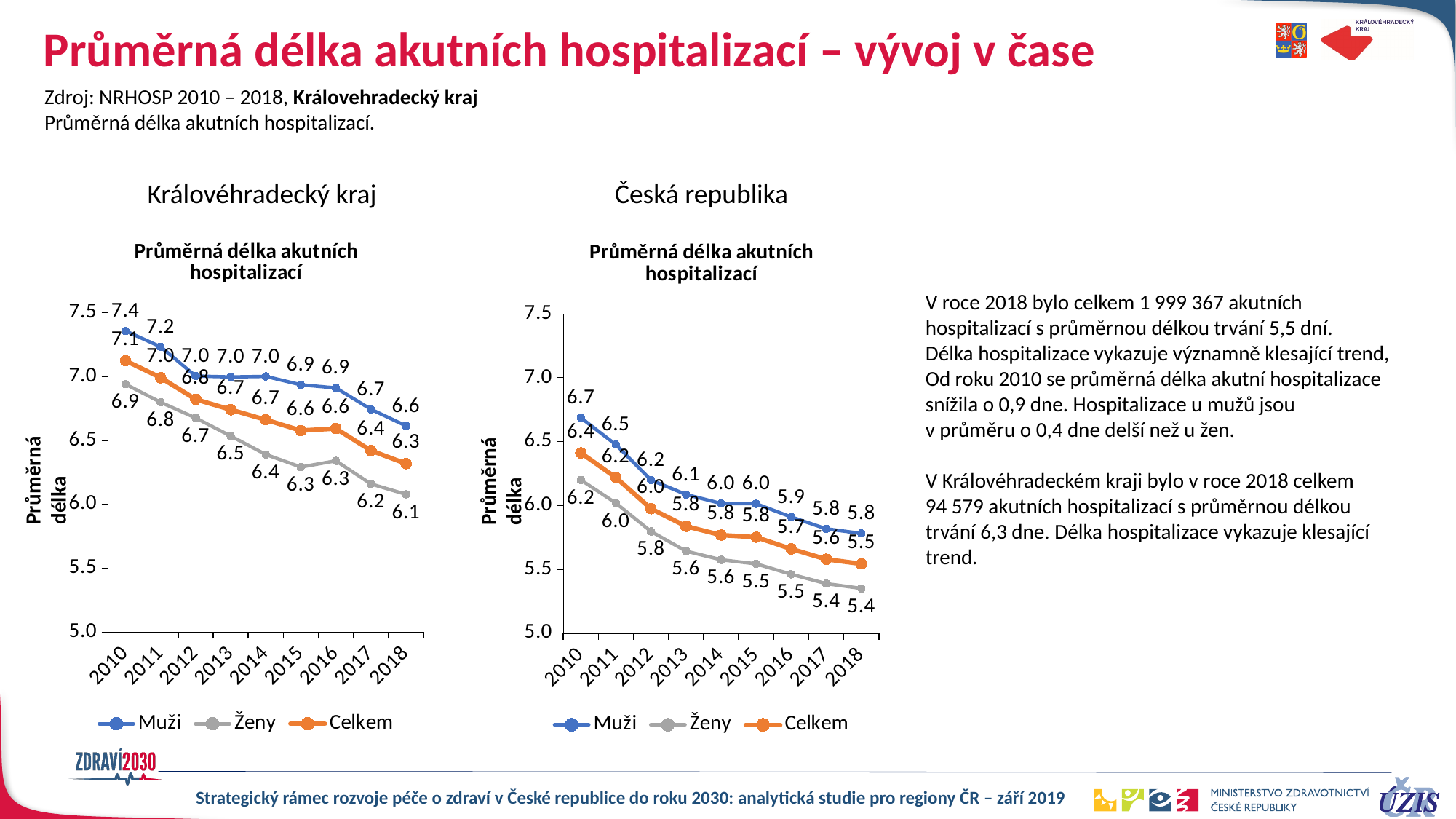
In the Královéhradecký kraj chart, what is the difference between the Muži value in 2010 and the Muži value in 2018? 0.8 In the Česká republika chart, is the value for Ženy in 2010 greater or less than 6.0? greater How many series does the legend of the Česká republika chart list? 3 In the Česká republika chart, what is the value for Muži in 2010? 6.7 What kind of chart is the Královéhradecký kraj chart? Line chart In the Česká republika chart, which year has the lowest value for Celkem? 2018 How many years are shown on the x axis of the Královéhradecký kraj chart? 9 In the Královéhradecký kraj chart, which year has the highest value for Ženy? 2010 In the Královéhradecký kraj chart, what is the value for Celkem in 2018? 6.3 In the Královéhradecký kraj chart, what is the value for Muži in 2010? 7.4 In the Česká republika chart, what is the value for Ženy in 2018? 5.4 In the Česká republika chart, which is larger in 2014: the value for Muži or the value for Ženy? Muži